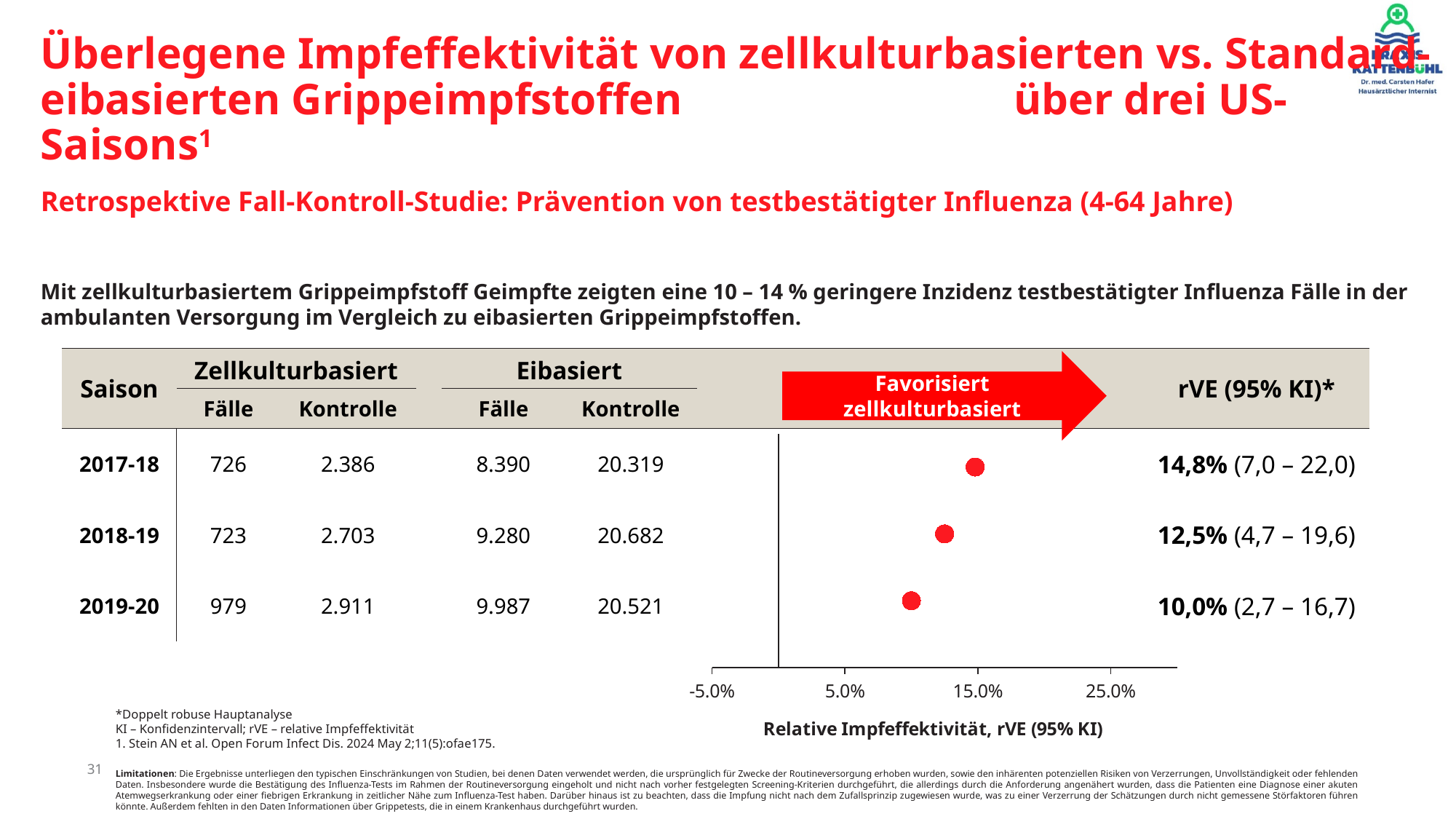
Which season has the larger rVE, 2018-19 or 2019-20? 2018-19 What is the rVE value plotted for the 2019-20 season? 10,0% Is the rVE point for 2019-20 greater or less than 15.0%? less What is the 95% confidence interval shown for the 2018-19 season? (4,7 – 19,6) What is the difference in rVE between the 2017-18 and 2019-20 seasons? 4,8 percentage points What kind of chart is used to display the rVE values? Dot plot (scatter chart) Which season has the lowest rVE point on the chart? 2019-20 How many seasons (data points) are plotted on the chart? 3 Do the rVE values rise or fall from the 2017-18 season to the 2019-20 season? Fall What is the rVE value plotted for the 2017-18 season? 14,8% Which season has the highest rVE point on the chart? 2017-18 What is the title of the horizontal axis of the chart? Relative Impfeffektivität, rVE (95% KI)